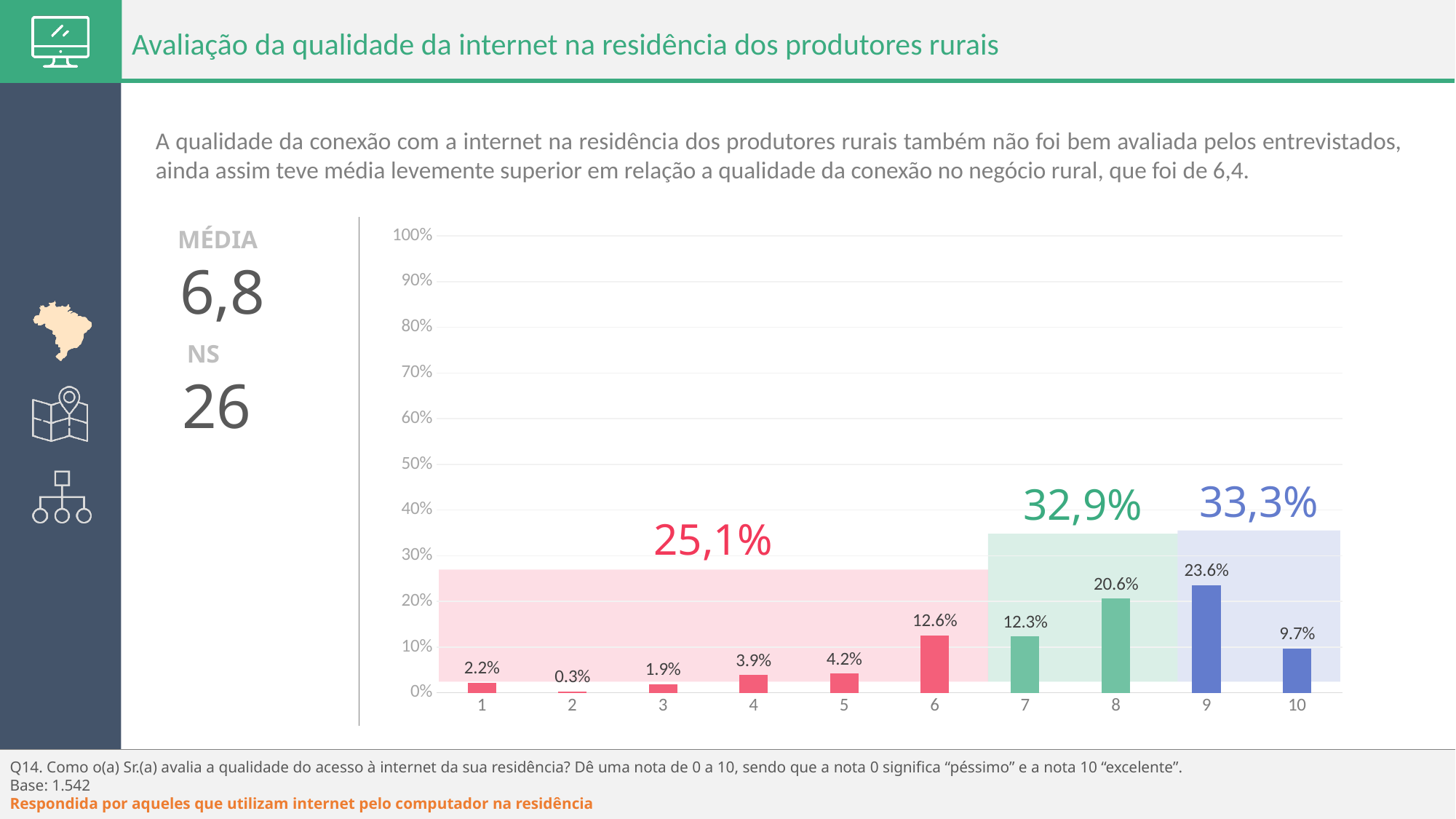
What kind of chart is shown on the slide? Bar chart Which score has the highest percentage of respondents? 9 What percentage of respondents gave a score of 9? 23.6% How many score categories are shown on the x axis? 10 What percentage of respondents gave a score of 2? 0.3% Which is larger, the value for score 6 or the value for score 7? Score 6 What is the difference in percentage points between the bars for score 9 and score 10? 13.9 Which score has the lowest percentage of respondents? 2 Is the value for score 8 greater or less than 30%? less What is the combined share shown for the green group (scores 7 and 8)? 32,9% What percentage of respondents gave a score of 8? 20.6% What is the average (MÉDIA) score shown next to the chart? 6,8